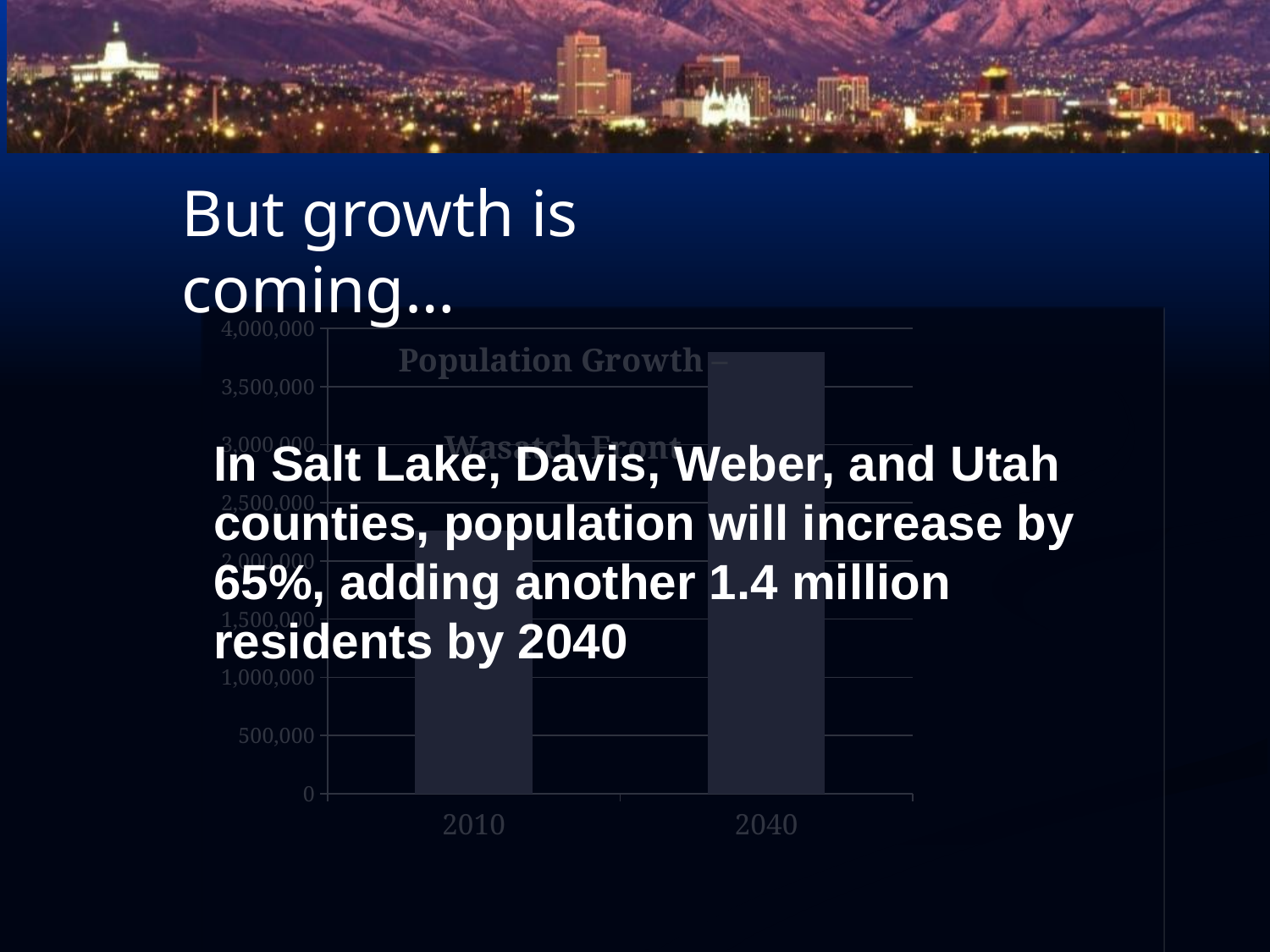
Is the value for 2010 greater or less than 2,500,000? less Do the values rise or fall from 2010 to 2040? rise What is the title of the chart? Population Growth – Wasatch Front Is the bar for 2010 taller or shorter than the bar for 2040? shorter What kind of chart is shown on the slide? bar chart Is the value for 2040 greater or less than 3,500,000? greater Is the value for 2010 greater or less than 2,000,000? greater Which year has the higher bar in the chart? 2040 What is the highest value shown on the chart's vertical axis? 4,000,000 How many categories are plotted on the x axis of the chart? 2 Which year has the lower bar in the chart? 2010